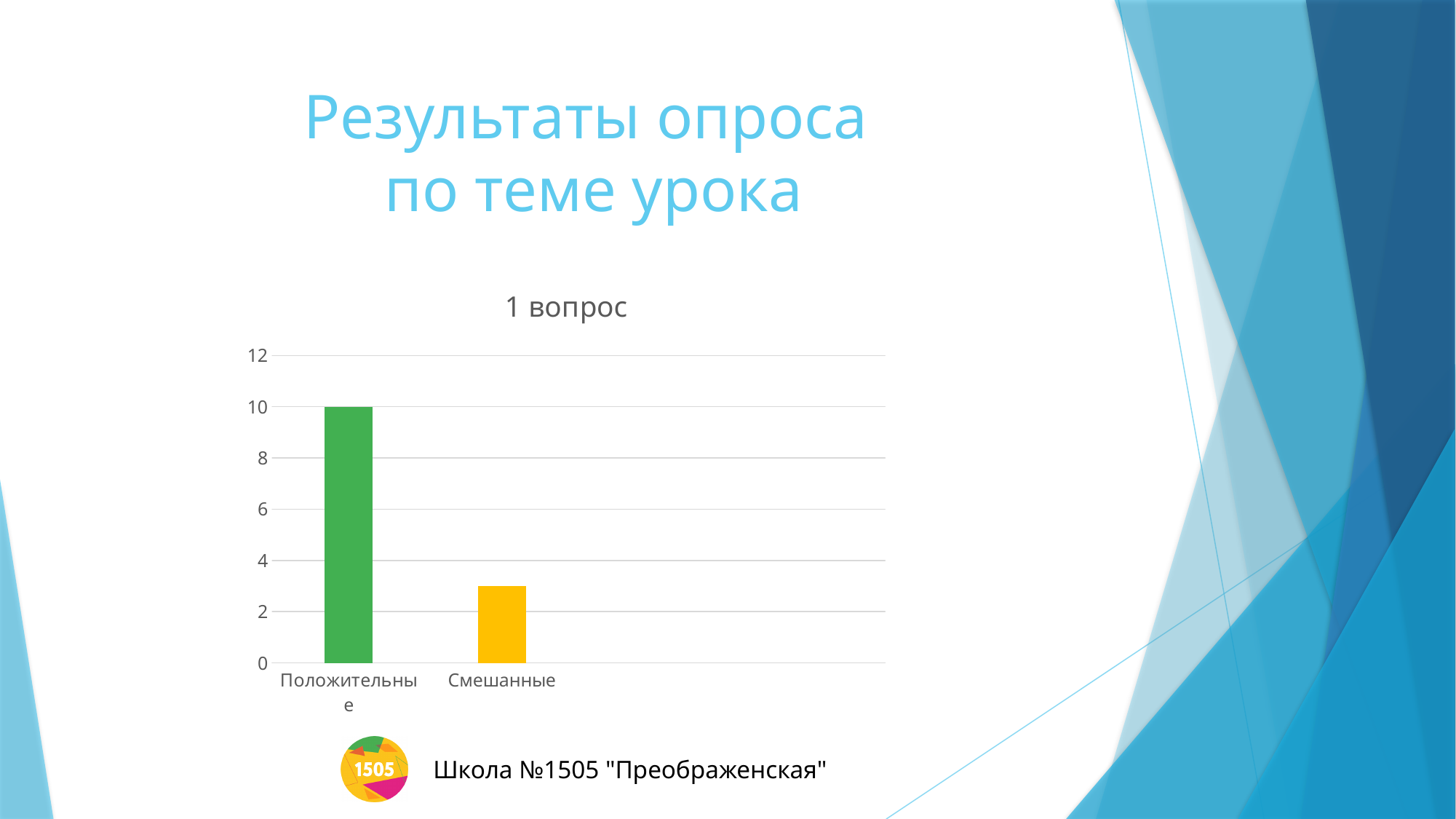
What is the title of the chart? 1 вопрос Which is larger, the value for Положительные or the value for Смешанные? Положительные What is the value for Положительные in the chart? 10 Which category has the lowest value in the chart? Смешанные Is the value for Положительные greater or less than 8? greater What is the highest value shown on the vertical axis of the chart? 12 Which category has the highest value in the chart? Положительные Is the value for Смешанные greater or less than 4? less What colour is the bar for Положительные? green How many categories are shown in the chart? 2 What kind of chart is shown on the slide? bar chart Is the value for Смешанные greater or less than 2? greater